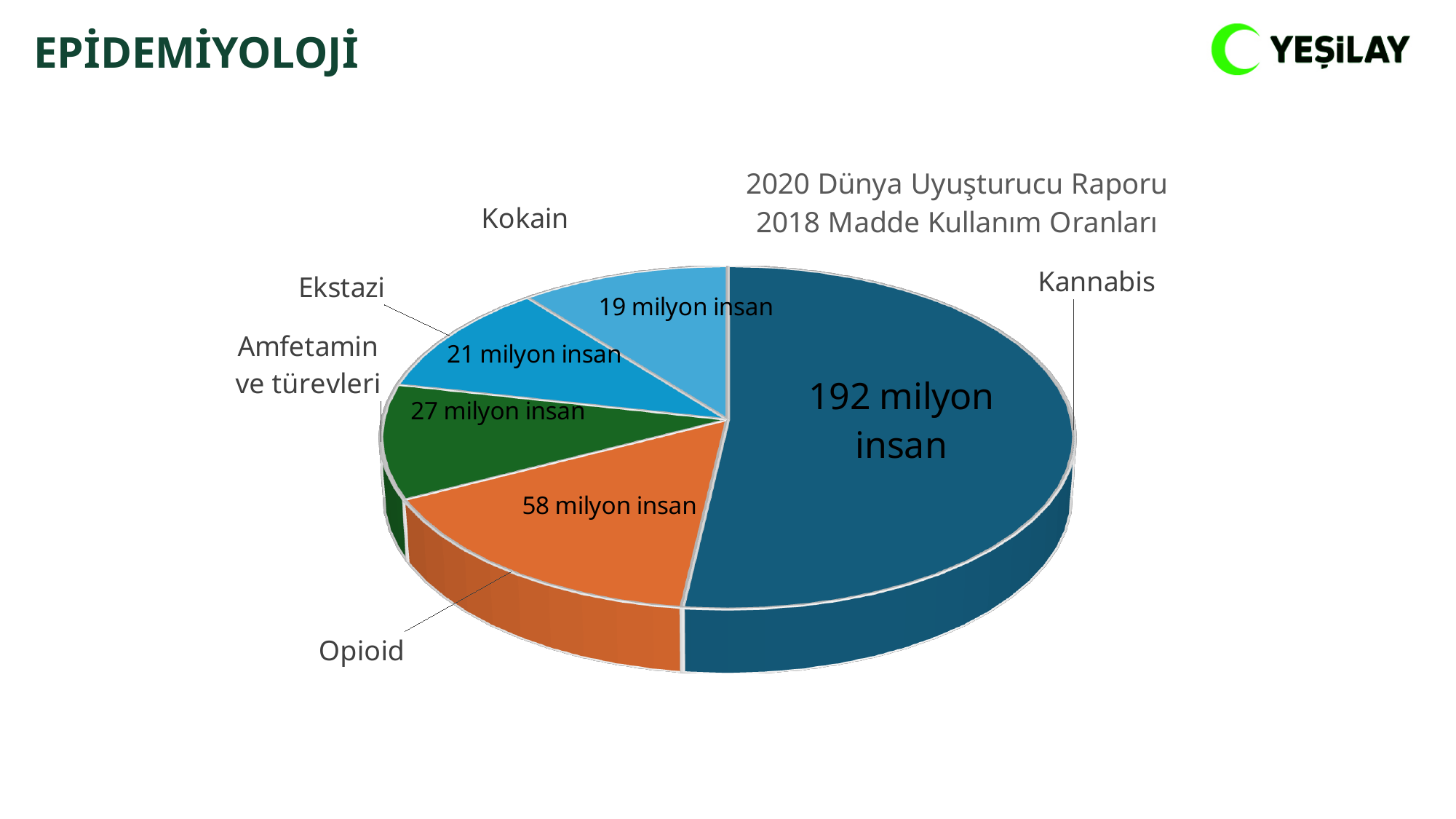
What is the title of the chart? 2020 Dünya Uyuşturucu Raporu 2018 Madde Kullanım Oranları What is the value shown for Amfetamin ve türevleri? 27 milyon insan What is the value shown for Kokain? 19 milyon insan Which is larger, the value for Ekstazi or the value for Amfetamin ve türevleri? Amfetamin ve türevleri What kind of chart is shown on the slide? Pie chart What is the difference between the values for Kannabis and Opioid? 134 milyon insan What is the value shown for Kannabis? 192 milyon insan What is the value shown for Opioid? 58 milyon insan How many slices does the pie chart have? 5 What is the value shown for Ekstazi? 21 milyon insan Which category has the largest slice? Kannabis